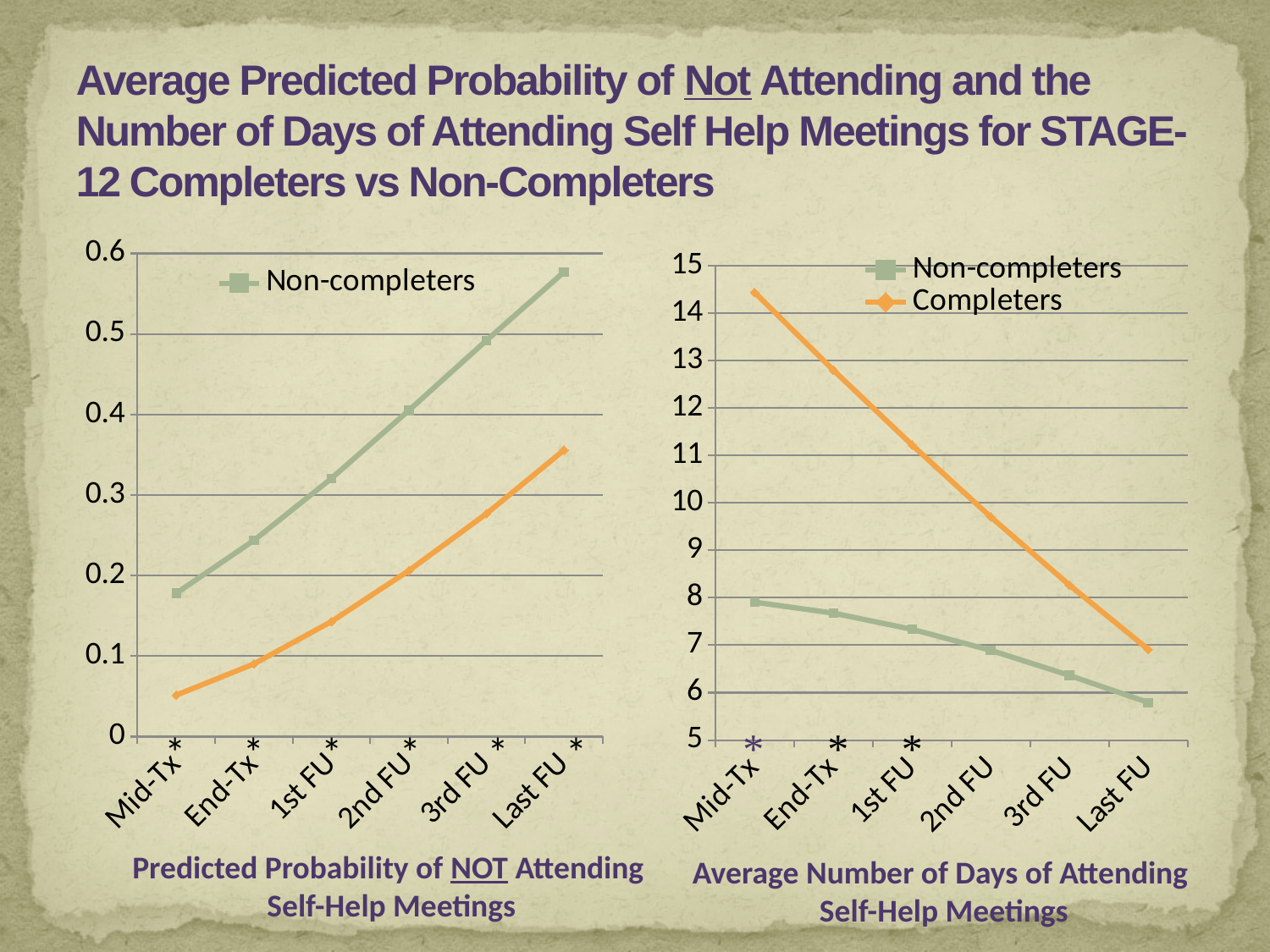
In the right chart, 'Average Number of Days of Attending Self-Help Meetings', do the Completers values rise or fall from Mid-Tx to Last FU? fall In the left chart, 'Predicted Probability of NOT Attending Self-Help Meetings', how many time points are plotted along the x axis? 6 In the right chart, 'Average Number of Days of Attending Self-Help Meetings', which series has the larger value at End-Tx, Completers or Non-completers? Completers In the left chart, 'Predicted Probability of NOT Attending Self-Help Meetings', which line is higher at 3rd FU, the green Non-completers line or the orange Completers line? Non-completers In the left chart, 'Predicted Probability of NOT Attending Self-Help Meetings', is the Non-completers value at Last FU greater or less than 0.5? greater In the right chart, 'Average Number of Days of Attending Self-Help Meetings', at which time point is the Completers value highest? Mid-Tx In the right chart, 'Average Number of Days of Attending Self-Help Meetings', how many series does the legend list? 2 In the left chart, 'Predicted Probability of NOT Attending Self-Help Meetings', is the orange (Completers) value at Mid-Tx greater or less than 0.1? less In the left chart, 'Predicted Probability of NOT Attending Self-Help Meetings', do the Non-completers values rise or fall from Mid-Tx to Last FU? rise In the right chart, 'Average Number of Days of Attending Self-Help Meetings', is the Completers value at Mid-Tx greater or less than 14? greater What kind of chart is the left chart, 'Predicted Probability of NOT Attending Self-Help Meetings'? line chart